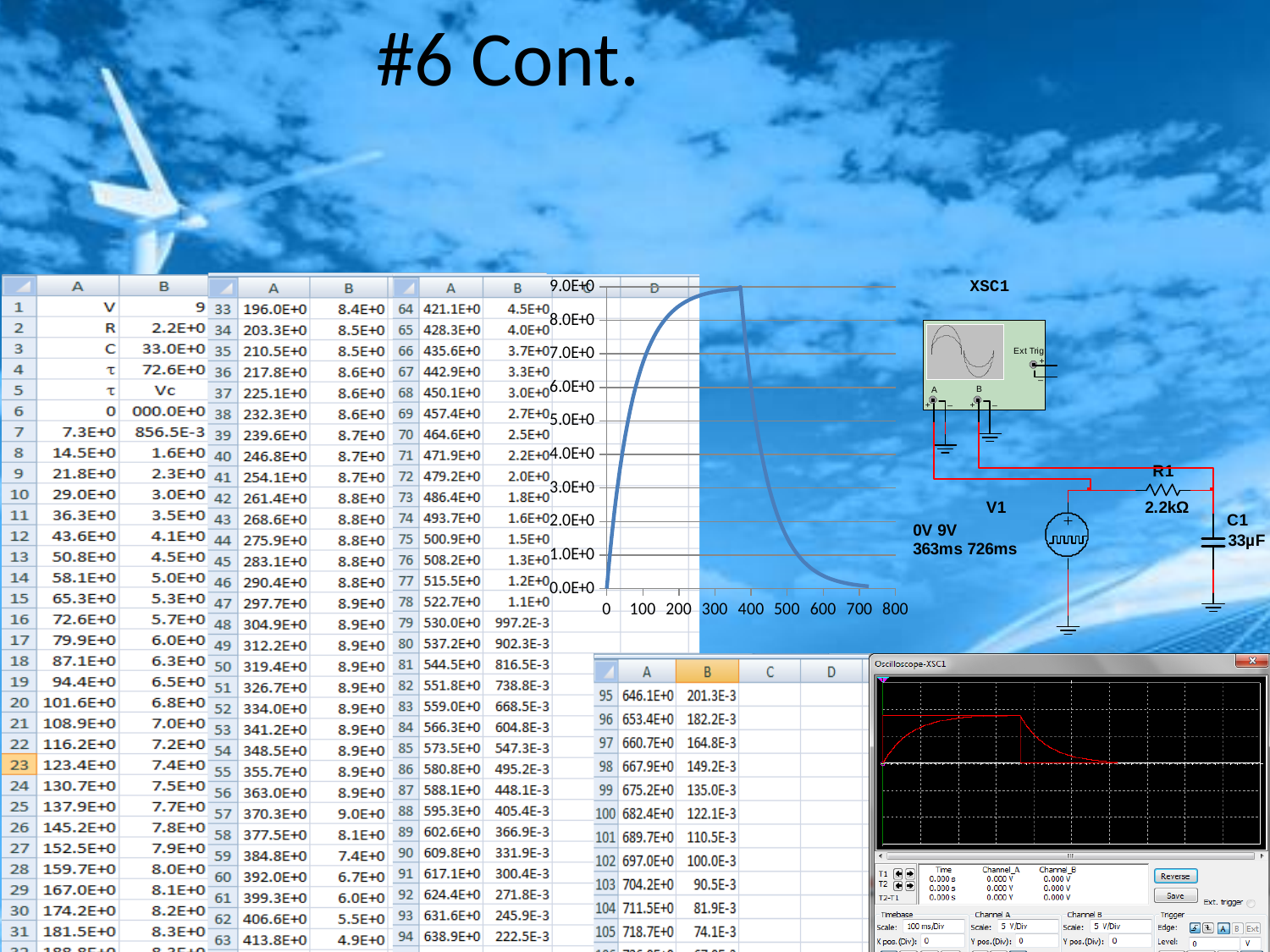
On the Excel line chart, what is the highest value shown on the y axis? 9.0E+0 On the Excel line chart, is the value at x = 300 greater or less than 8.0E+0? greater On the Excel line chart, does the line rise or fall between x = 0 and x = 300? rise In the Oscilloscope-XSC1 window at the bottom right, what is the Timebase scale setting? 100 ms/Div On the Excel line chart, does the line rise or fall between x = 400 and x = 800? fall On the Excel line chart, is the value at x = 700 greater or less than 1.0E+0? less On the Excel line chart, is the value at x = 200 greater or less than 7.0E+0? greater On the Excel line chart, what is the largest tick value shown on the x axis? 800 On the Excel line chart, how many tick labels are shown on the x axis? 9 What kind of chart is the Excel chart in the middle of the slide? line chart On the Excel line chart, which is larger: the value at x = 300 or the value at x = 600? x = 300